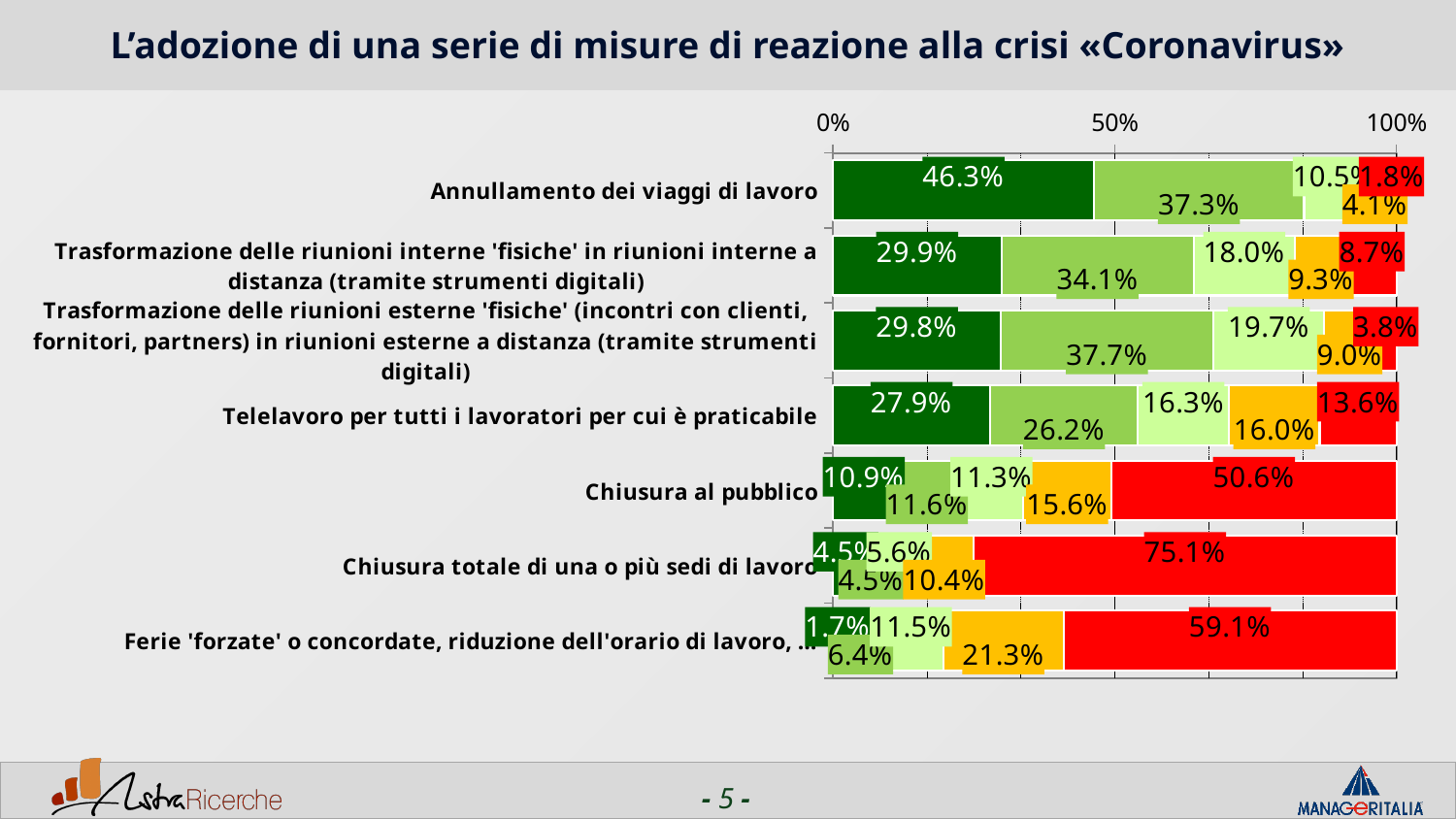
What is the value of the red segment for 'Chiusura al pubblico'? 50.6% Which measure has the largest dark green segment? Annullamento dei viaggi di lavoro What is the value of the orange segment for 'Ferie 'forzate' o concordate, riduzione dell'orario di lavoro, ...'? 21.3% Which is larger: the red segment for 'Chiusura al pubblico' or the red segment for 'Ferie 'forzate' o concordate, riduzione dell'orario di lavoro, ...'? Ferie 'forzate' o concordate, riduzione dell'orario di lavoro, ... What is the difference between the dark green segment for 'Annullamento dei viaggi di lavoro' (46.3%) and the dark green segment for 'Trasformazione delle riunioni interne' (29.9%)? 16.4 percentage points Which measure has the smallest dark green segment? Ferie 'forzate' o concordate, riduzione dell'orario di lavoro, ... What is the value of the dark green segment for 'Telelavoro per tutti i lavoratori per cui è praticabile'? 27.9% How many measures (categories) are listed on the chart? 7 What is the value of the red segment for 'Chiusura totale di una o più sedi di lavoro'? 75.1% Which measure has the largest red segment? Chiusura totale di una o più sedi di lavoro What kind of chart is shown on the slide? Stacked bar chart What is the value of the dark green segment for 'Annullamento dei viaggi di lavoro'? 46.3%